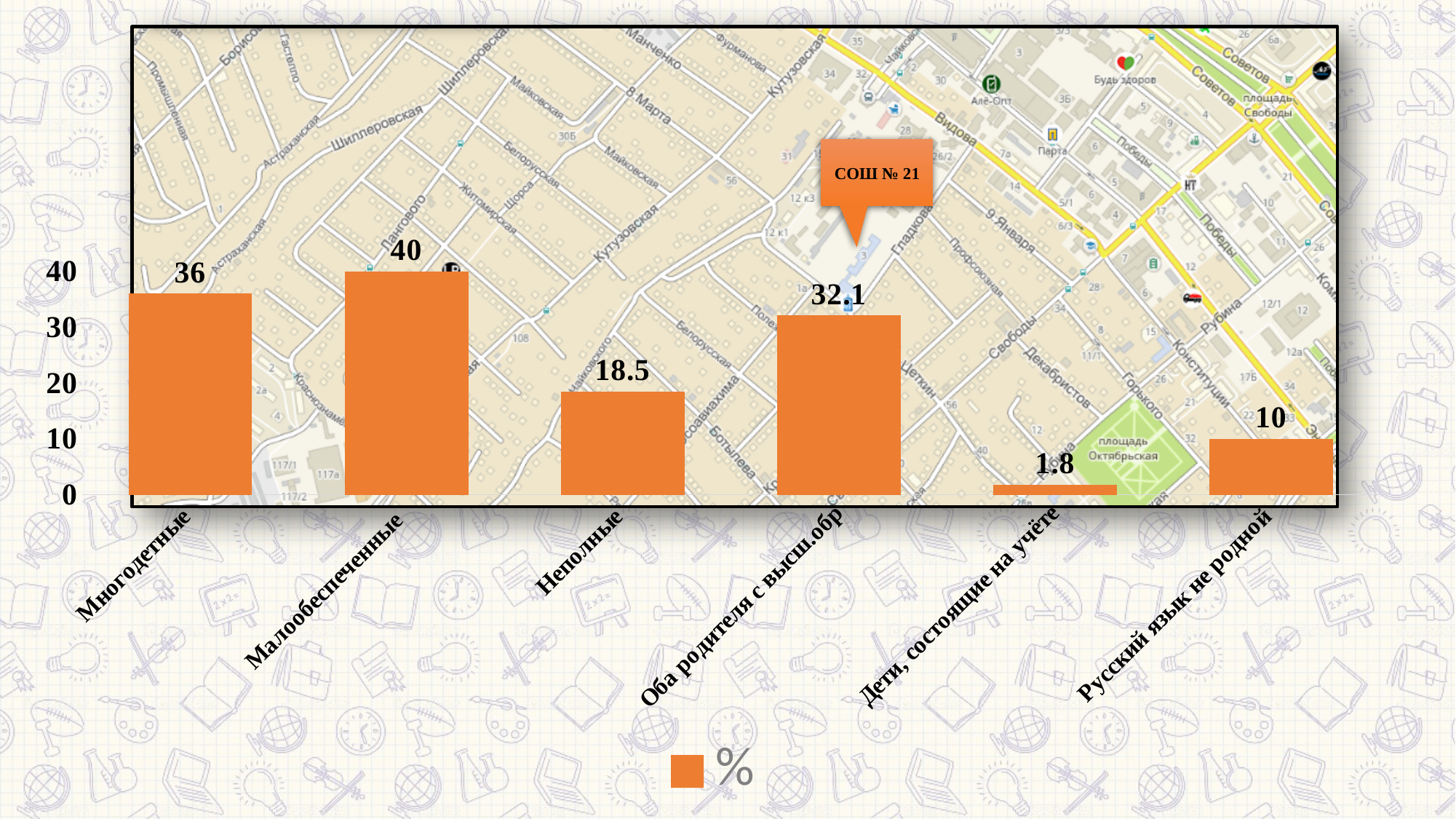
What is the value for Русский язык не родной? 10 Which category has the highest value? Малообеспеченные What kind of chart is shown on the slide? Bar chart Which is larger, the value for Многодетные or the value for Оба родителя с высш.обр? Многодетные What is the difference between the values for Малообеспеченные and Неполные? 21.5 Which category has the lowest value? Дети, состоящие на учёте What is the value for Оба родителя с высш.обр? 32.1 How many series does the legend list? 1 How many categories are shown on the chart? 6 What is the legend entry for the series? % What is the value for Многодетные? 36 What is the value for Дети, состоящие на учёте? 1.8